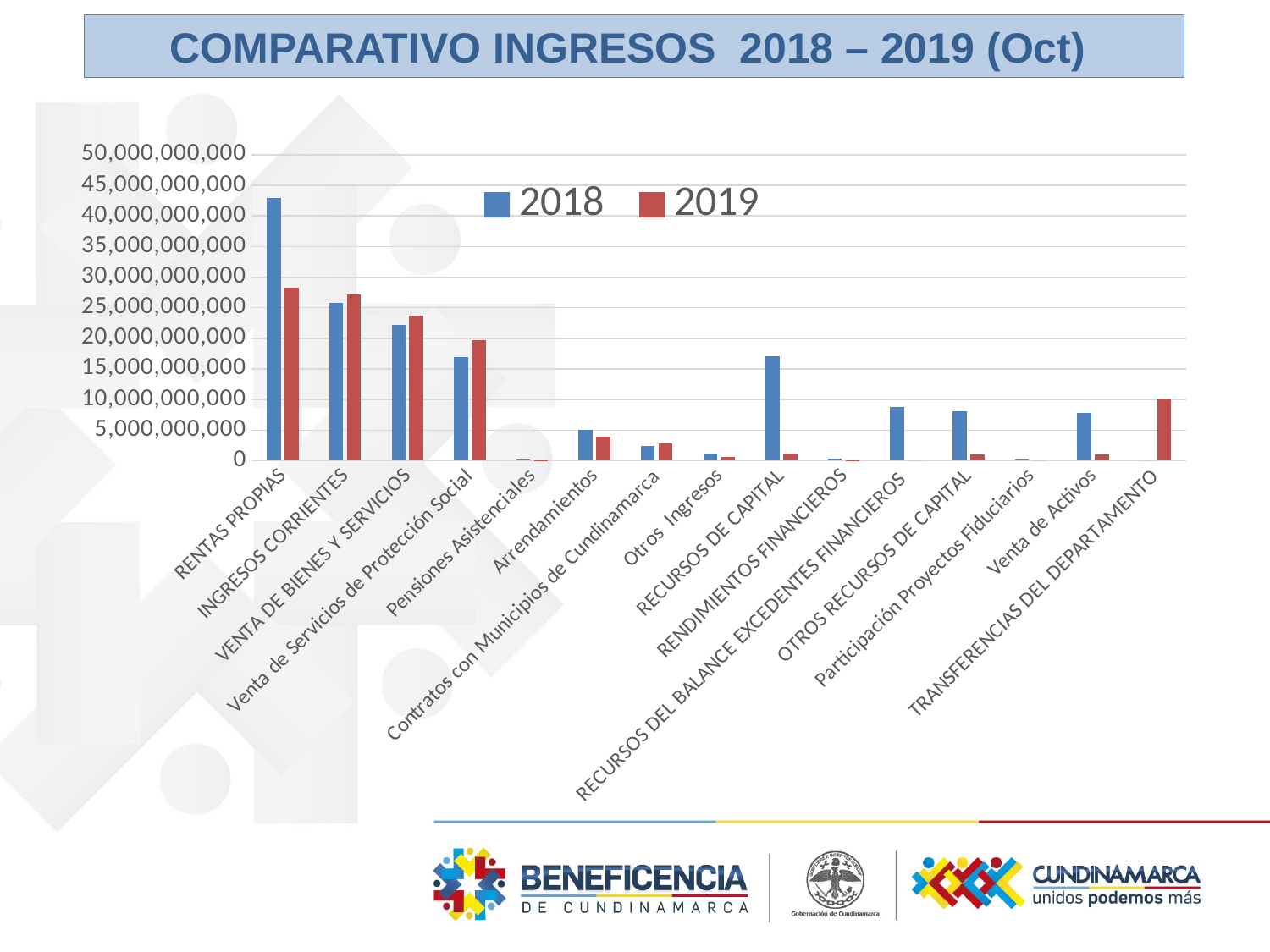
For TRANSFERENCIAS DEL DEPARTAMENTO, which year has the larger value, 2018 or 2019? 2019 Which category has the highest 2018 value? RENTAS PROPIAS What kind of chart is shown on the slide? Bar chart For RECURSOS DE CAPITAL, which year has the larger value, 2018 or 2019? 2018 For RENTAS PROPIAS, which year has the larger value, 2018 or 2019? 2018 How many series does the legend list? 2 Is the 2018 value for RENTAS PROPIAS greater or less than 40,000,000,000? greater Is the 2019 value for RECURSOS DE CAPITAL greater or less than 5,000,000,000? less What is the title of the chart? COMPARATIVO INGRESOS 2018 – 2019 (Oct) Which category has the highest 2019 value? RENTAS PROPIAS Is the 2019 value for TRANSFERENCIAS DEL DEPARTAMENTO greater or less than 5,000,000,000? greater How many categories are shown on the x axis? 15